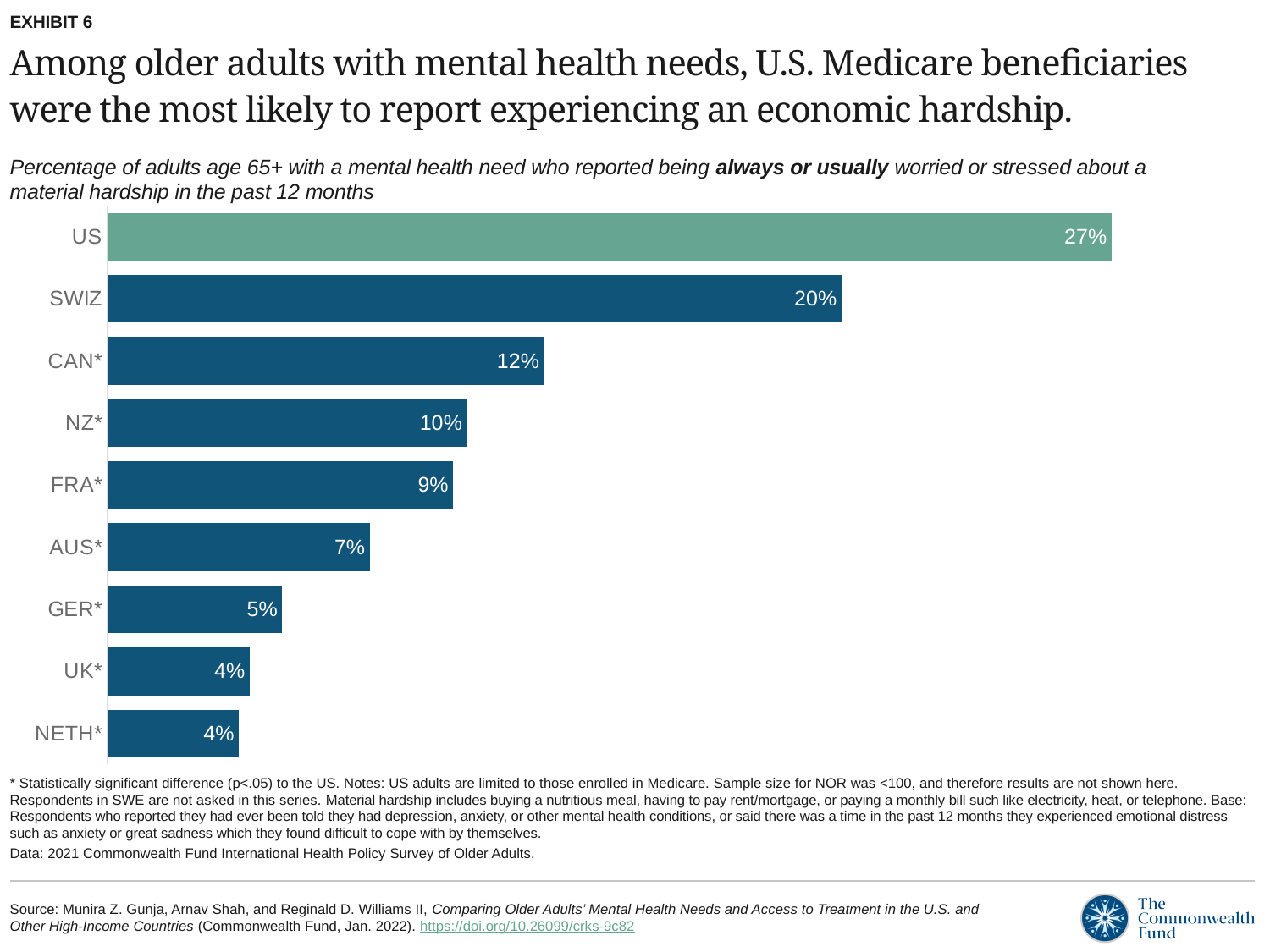
What percentage is shown for SWIZ? 20% Which country has the lowest percentage, excluding ties? Name the two countries tied at the lowest value. UK* and NETH* What percentage is shown for FRA*? 9% How many countries are shown in the chart? 9 What is the difference between the CAN* and GER* percentages? 7 percentage points What is the difference between the US and SWIZ percentages? 7 percentage points Which bar is shown in a different colour from the others? US What percentage is shown for the US? 27% Do the values rise or fall going from the top bar to the bottom bar? Fall Which is larger, the value for NZ* or the value for AUS*? NZ* Which country has the highest percentage? US What kind of chart is this? Bar chart